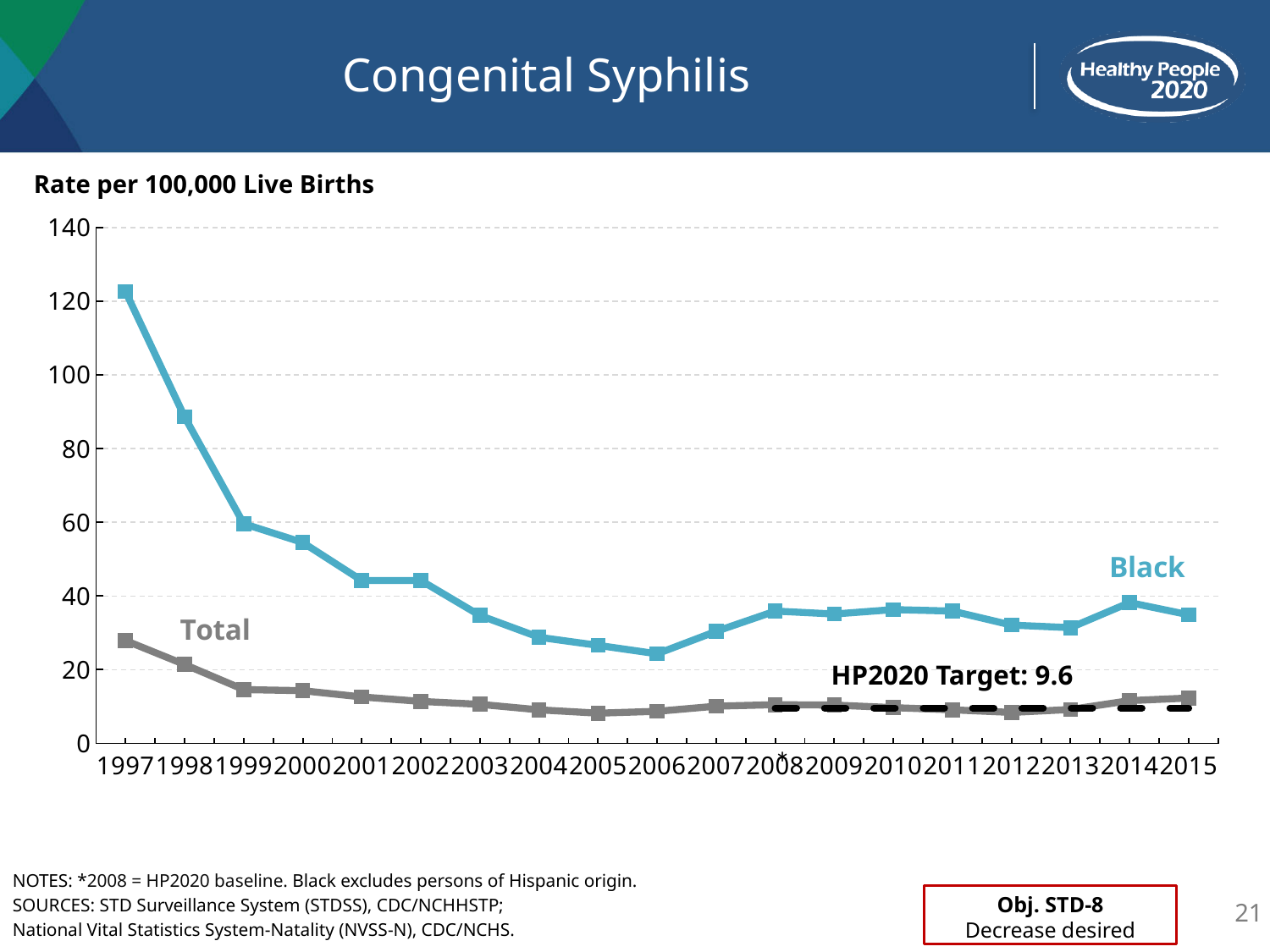
How many years are shown along the x axis of the chart? 19 What is the HP2020 Target value shown on the chart? 9.6 In which year is the rate for Black highest? 1997 Which two population groups are plotted as lines on the chart? Black and Total Does the rate for Black rise or fall from 1997 to 2006? fall In 2010, which is larger, the rate for Black or the rate for Total? Black What is the y-axis label of the chart? Rate per 100,000 Live Births In which year is the rate for Black lowest? 2006 Is the rate for Black in 1999 greater or less than 80? less What kind of chart is shown on the slide? Line chart Is the rate for Total in 2005 greater or less than 20? less Is the rate for Black in 1997 greater or less than 100? greater